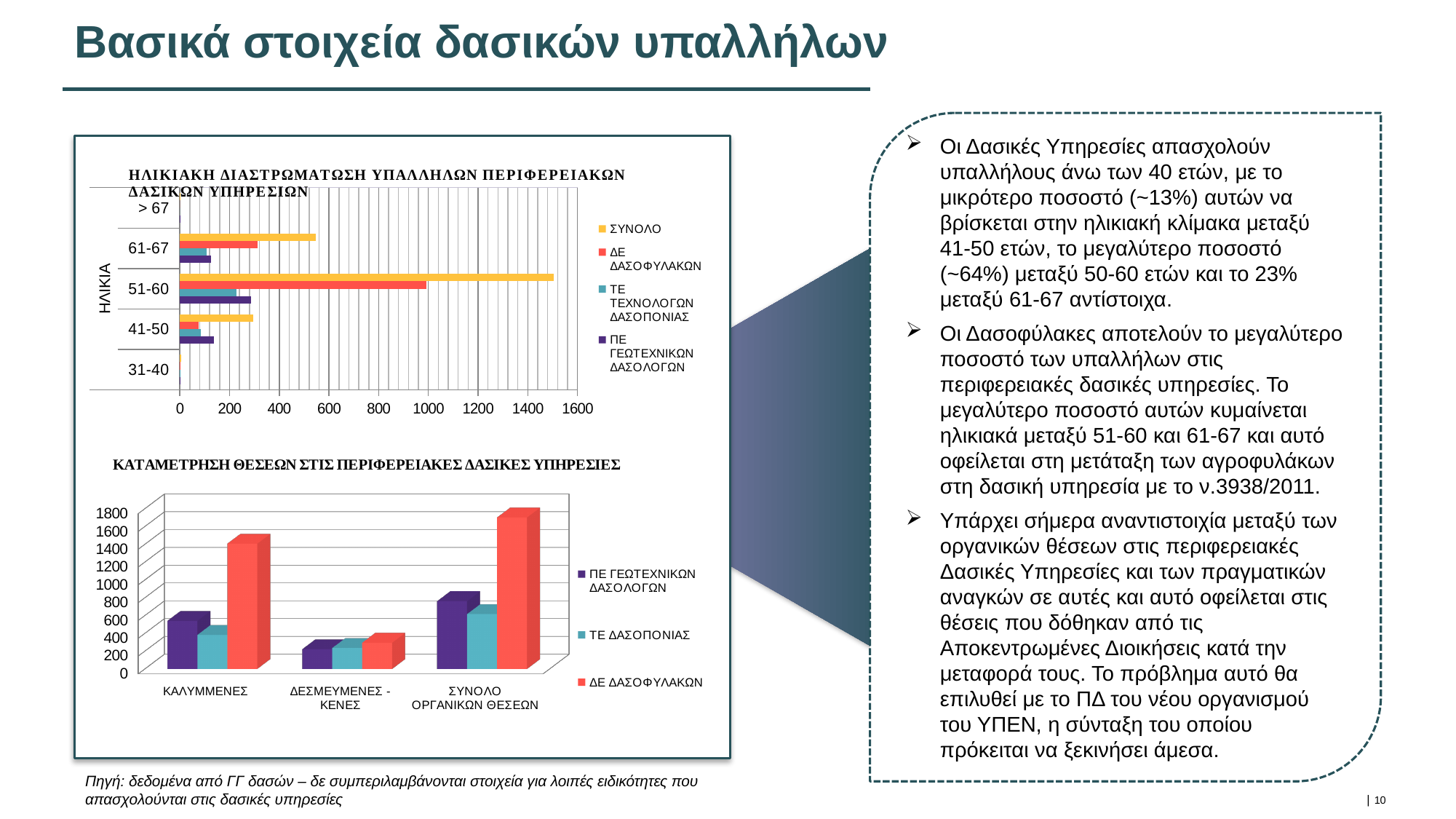
In the bottom chart, which series has the highest value for ΚΑΛΥΜΜΕΝΕΣ? ΔΕ ΔΑΣΟΦΥΛΑΚΩΝ How many age categories are shown on the y axis of the top chart? 5 In the top chart, is the ΣΥΝΟΛΟ value for 51-60 greater or less than 1400? greater In the top chart, is the ΣΥΝΟΛΟ value for 61-67 greater or less than 400? greater In the top chart, is the ΔΕ ΔΑΣΟΦΥΛΑΚΩΝ value for 51-60 greater or less than 800? greater In the top chart, which age group has the highest ΣΥΝΟΛΟ value? 51-60 How many series does the legend of the bottom chart, 'ΚΑΤΑΜΕΤΡΗΣΗ ΘΕΣΕΩΝ ΣΤΙΣ ΠΕΡΙΦΕΡΕΙΑΚΕΣ ΔΑΣΙΚΕΣ ΥΠΗΡΕΣΙΕΣ', list? 3 In the bottom chart, which is larger for ΚΑΛΥΜΜΕΝΕΣ: ΠΕ ΓΕΩΤΕΧΝΙΚΩΝ ΔΑΣΟΛΟΓΩΝ or ΤΕ ΔΑΣΟΠΟΝΙΑΣ? ΠΕ ΓΕΩΤΕΧΝΙΚΩΝ ΔΑΣΟΛΟΓΩΝ What kind of chart is the top chart, 'ΗΛΙΚΙΑΚΗ ΔΙΑΣΤΡΩΜΑΤΩΣΗ ΥΠΑΛΛΗΛΩΝ ΠΕΡΙΦΕΡΕΙΑΚΩΝ ΔΑΣΙΚΩΝ ΥΠΗΡΕΣΙΩΝ'? Bar chart How many series does the legend of the top chart list? 4 In the top chart, which is larger: the ΣΥΝΟΛΟ value for 61-67 or for 41-50? 61-67